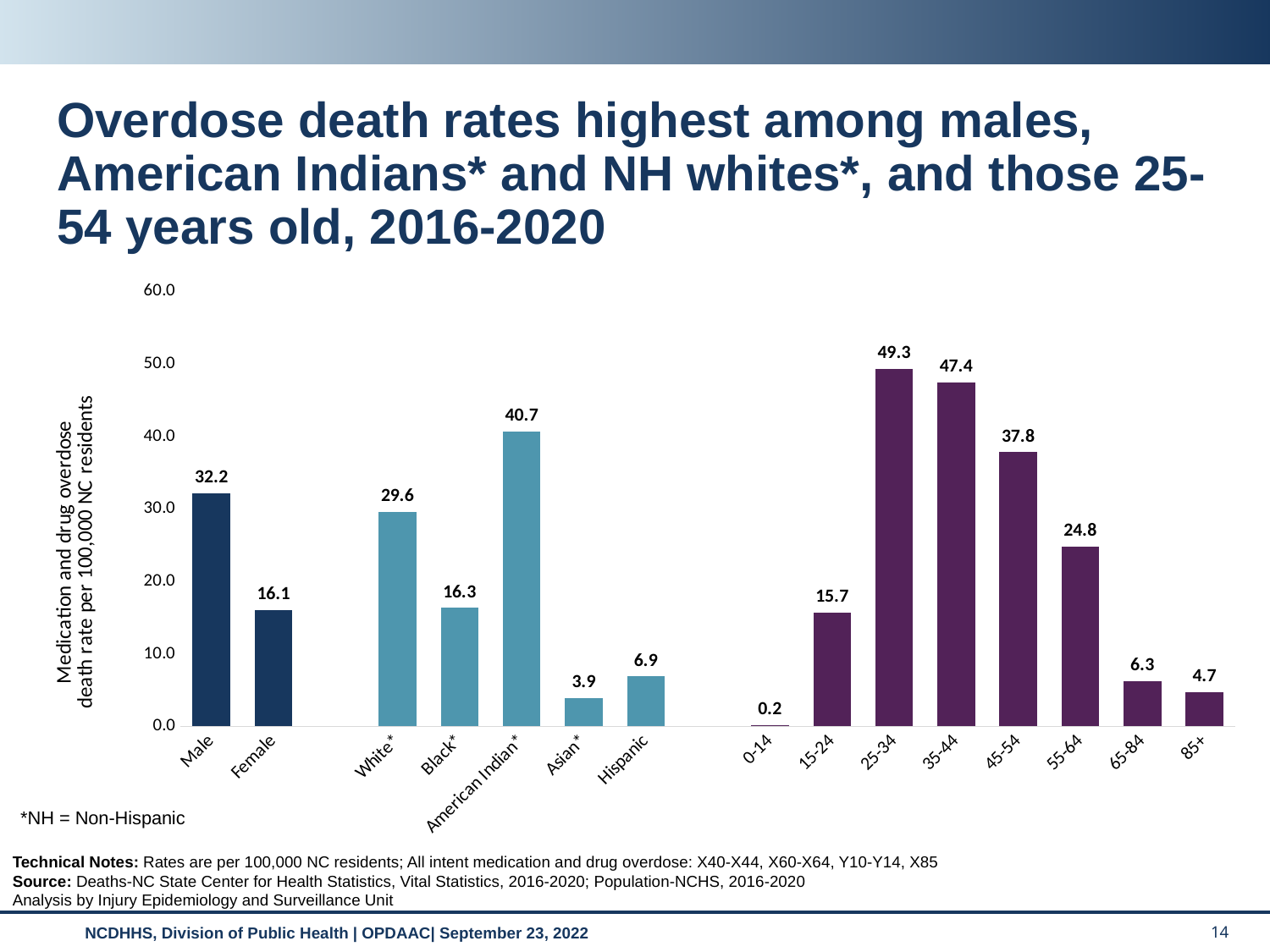
How many age groups are shown on the chart? 8 Which age group has the lowest overdose death rate? 0-14 What type of chart is shown on the slide? Bar chart Which age group has the highest overdose death rate? 25-34 What is the overdose death rate for the 55-64 age group? 24.8 What is the label of the vertical axis? Medication and drug overdose death rate per 100,000 NC residents What is the overdose death rate for American Indians*? 40.7 What is the difference between the male and female overdose death rates? 16.1 Which has a higher overdose death rate, White* or Black*? White* Which race/ethnicity group has the lowest overdose death rate? Asian* What is the difference between the overdose death rates for the 25-34 and 35-44 age groups? 1.9 What is the overdose death rate for males? 32.2